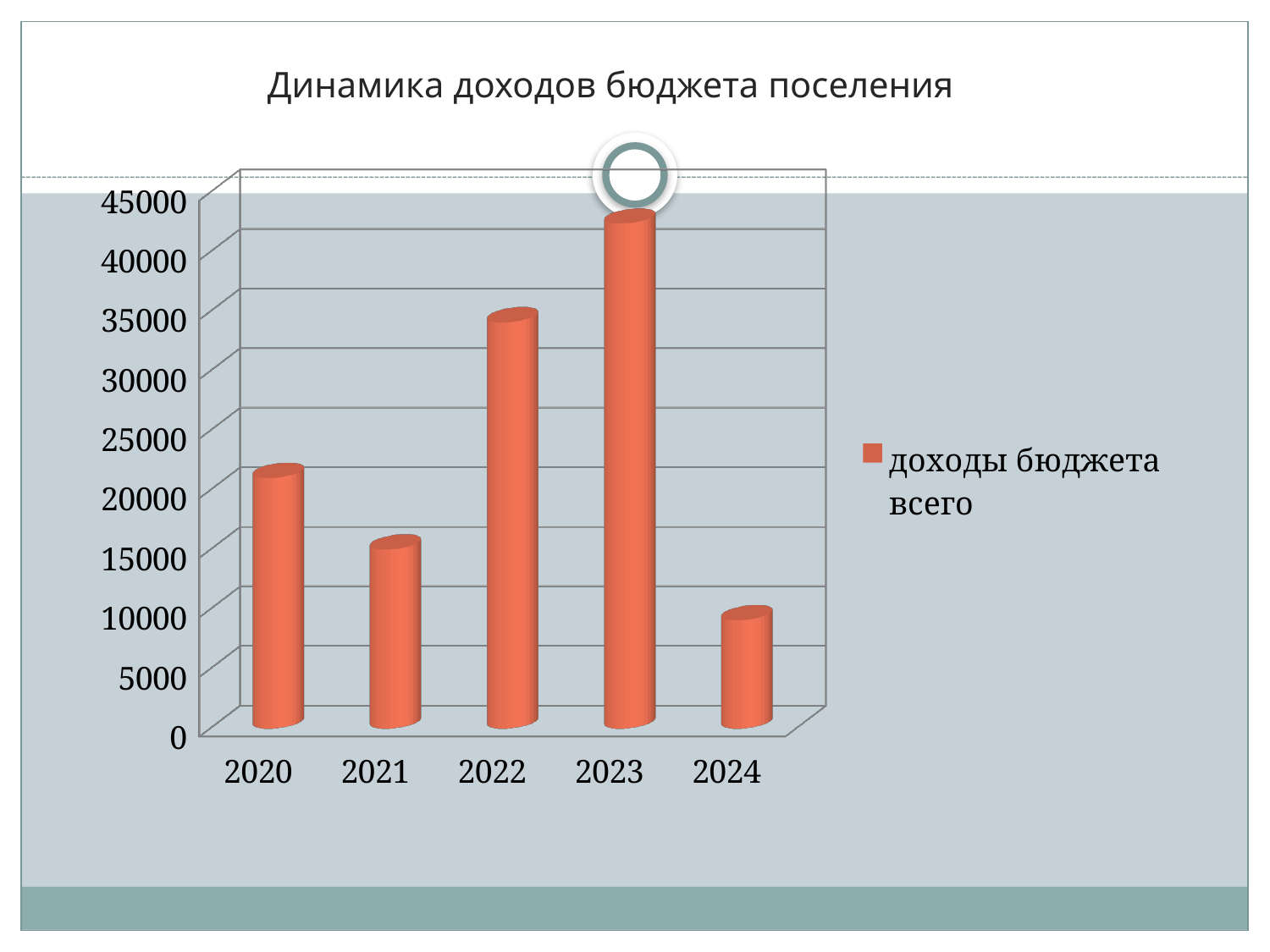
Which year has the highest value? 2023 Is the value for 2021 greater or less than 20000? less Which is larger, the value for 2022 or the value for 2021? 2022 Does the value rise or fall from 2023 to 2024? fall What kind of chart is shown on the slide? bar chart What is the name of the series shown in the legend? доходы бюджета всего How many years are shown on the x axis of the chart? 5 Is the value for 2023 greater or less than 40000? greater Is the value for 2022 greater or less than 30000? greater Which year has the lowest value? 2024 What is the title of the chart? Динамика доходов бюджета поселения How many series does the legend list? 1